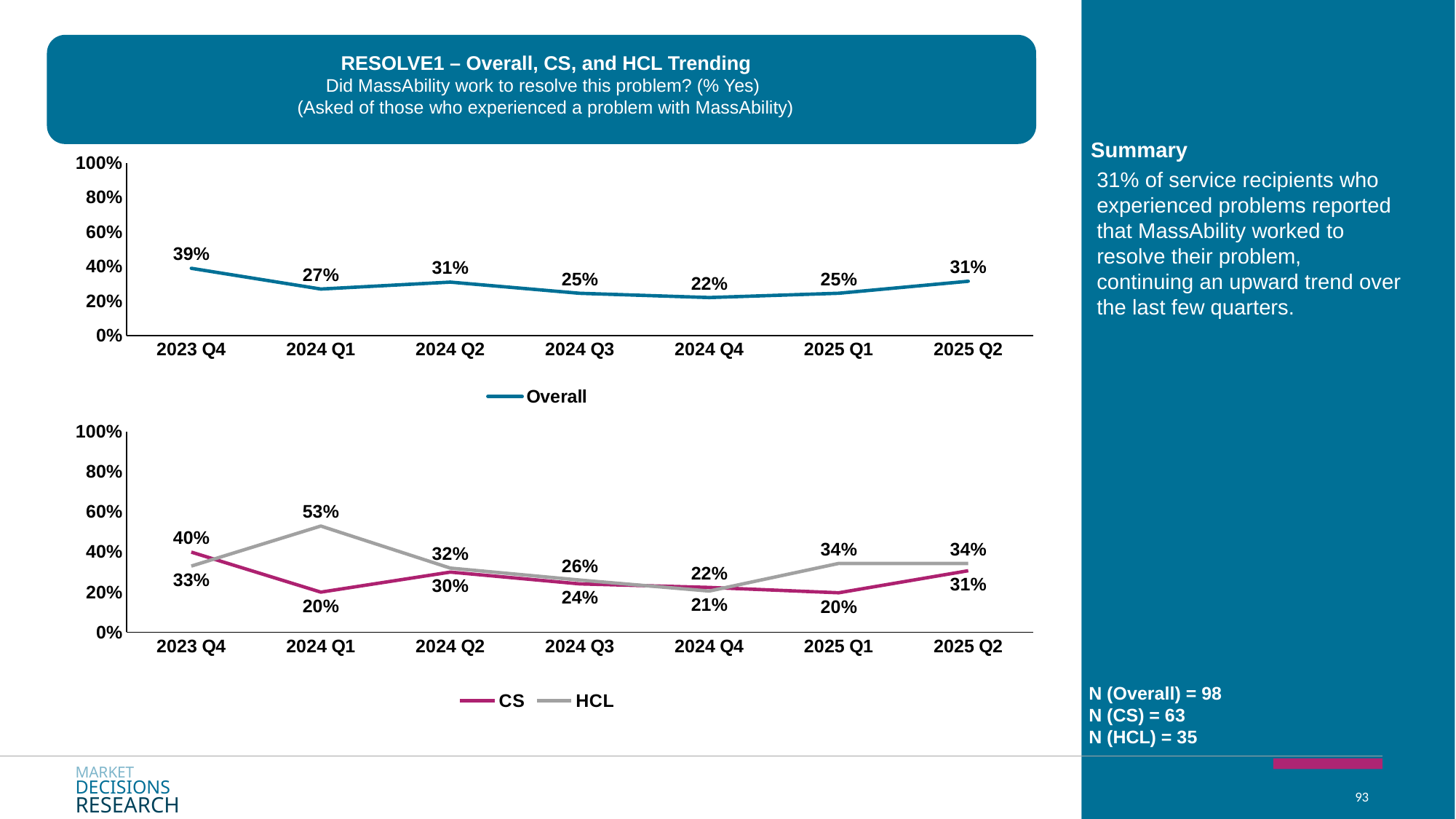
In the bottom chart (CS and HCL), what is the CS value for 2025 Q1? 20% In the top chart (Overall), which quarter has the highest value? 2023 Q4 In the top chart (Overall), which quarter has the lowest value? 2024 Q4 In the bottom chart (CS and HCL), how many series does the legend list? 2 In the top chart (Overall), what is the value for 2024 Q4? 22% In the bottom chart (CS and HCL), what is the HCL value for 2024 Q1? 53% In the bottom chart (CS and HCL), is the HCL value for 2024 Q1 greater or less than 40%? greater What kind of chart is the top chart (Overall)? Line chart In the bottom chart (CS and HCL), what is the difference between the HCL and CS values in 2024 Q1? 33% In the top chart (Overall), how many quarters are plotted along the x axis? 7 In the bottom chart (CS and HCL), which series has the higher value in 2023 Q4, CS or HCL? CS In the top chart (Overall), what is the difference between the 2023 Q4 value and the 2025 Q2 value? 8%